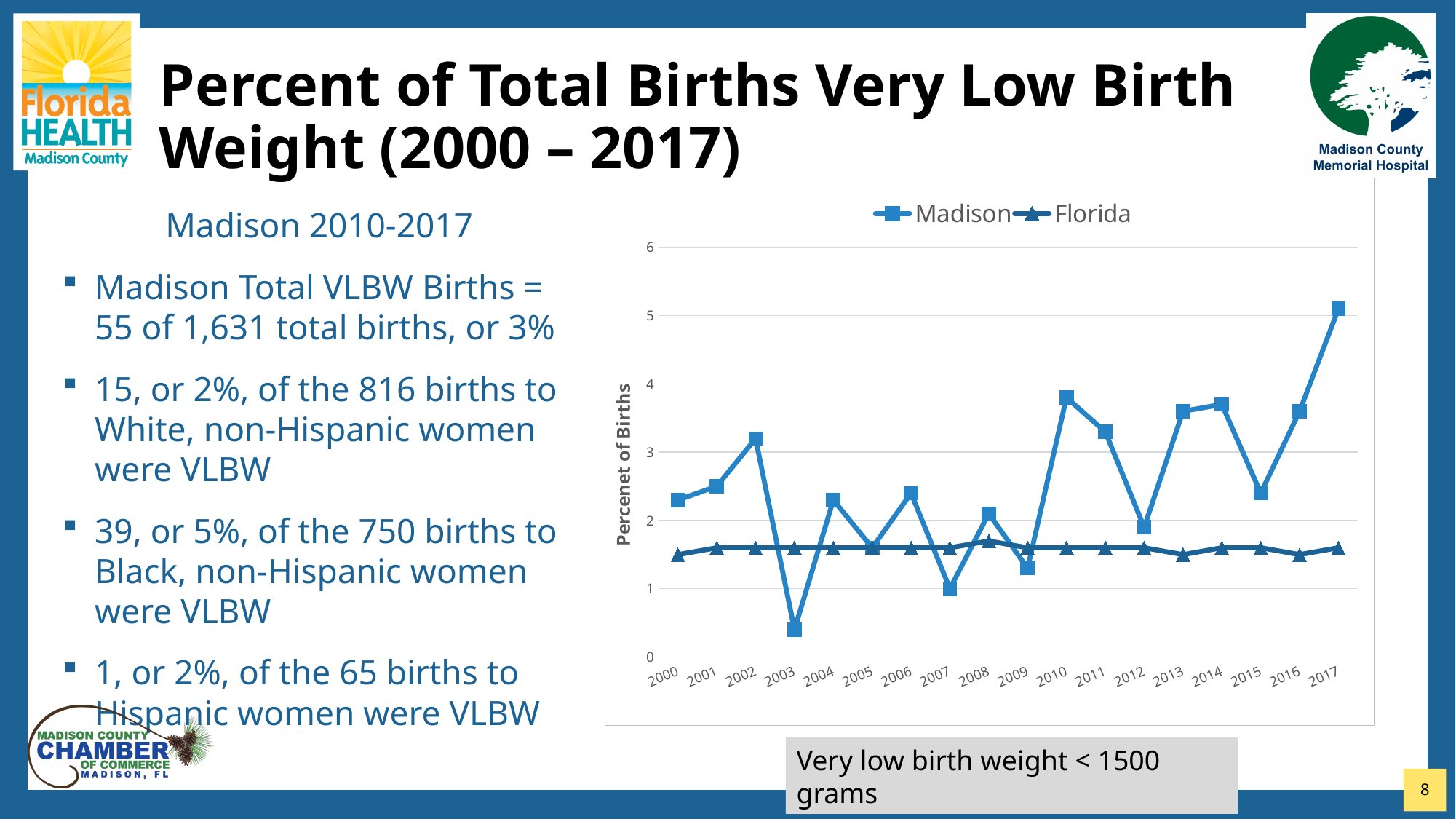
Is the Florida value for 2010 greater or less than 2? less In 2007, which series has the larger value, Madison or Florida? Florida In which year does the Madison series reach its highest value? 2017 Is the Madison value for 2010 greater or less than 3? greater In 2017, which series has the larger value, Madison or Florida? Madison What kind of chart is shown on the slide? Line chart How many years are plotted along the x axis of the chart? 18 How many series does the chart's legend list? 2 In which year does the Madison series reach its lowest value? 2003 Is the Madison value for 2017 greater or less than 4? greater Does the Madison series rise or fall from 2015 to 2017? Rise